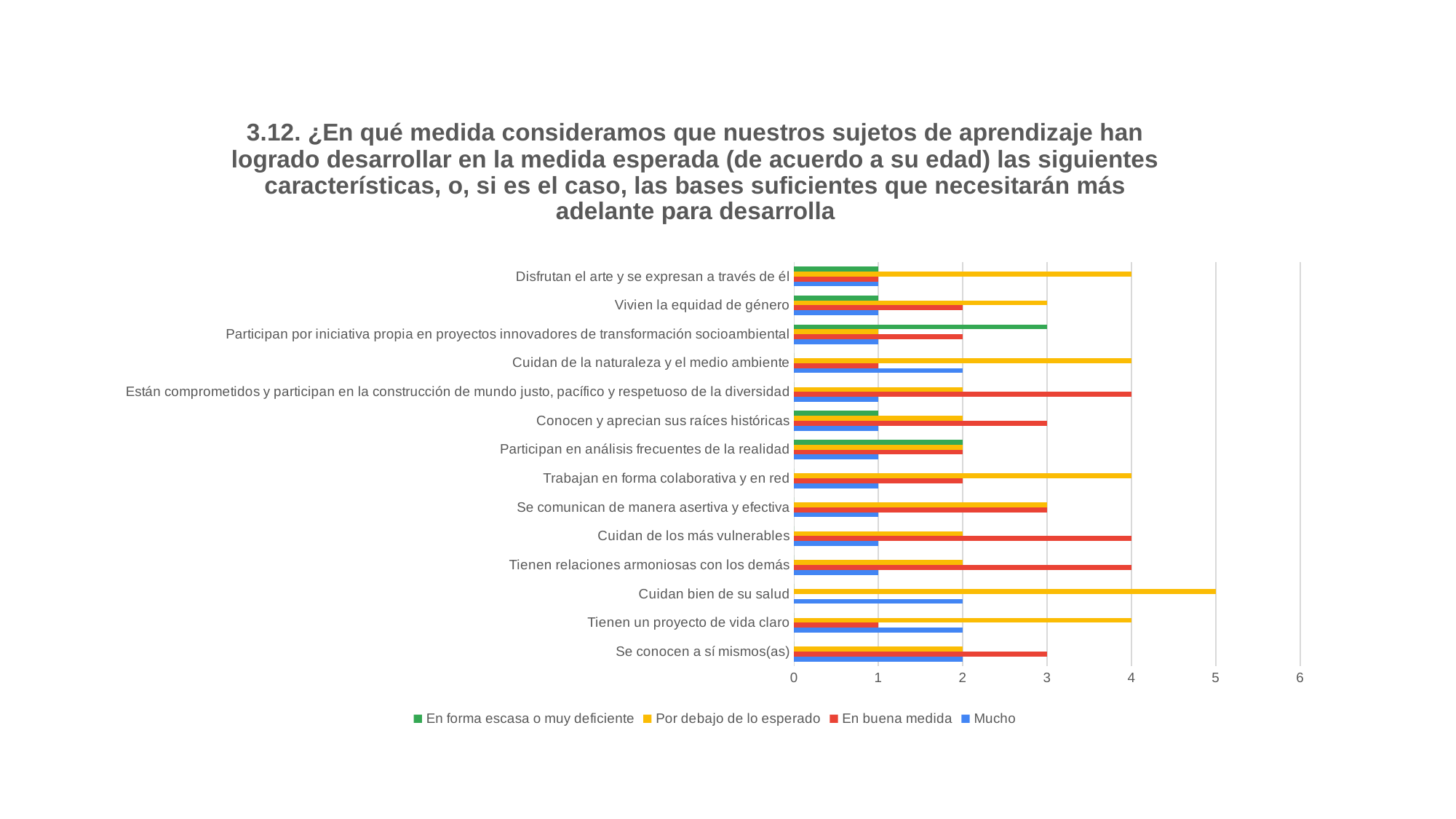
How many series does the legend list? 4 For "Conocen y aprecian sus raíces históricas", which is larger: "En buena medida" or "Por debajo de lo esperado"? En buena medida How many categories are plotted on the chart? 14 What is the value of "Por debajo de lo esperado" for "Cuidan bien de su salud"? 5 Is the value of "Por debajo de lo esperado" for "Cuidan bien de su salud" greater or less than 4? greater What is the value of "En forma escasa o muy deficiente" for "Participan por iniciativa propia en proyectos innovadores de transformación socioambiental"? 3 What is the difference between "Por debajo de lo esperado" and "En buena medida" for "Disfrutan el arte y se expresan a través de él"? 3 What is the value of "En buena medida" for "Cuidan de los más vulnerables"? 4 Which colour represents the "Mucho" series in the legend? blue What kind of chart is shown on the slide? bar chart What is the value of "Mucho" for "Se conocen a sí mismos(as)"? 2 Which category has the highest value for "Por debajo de lo esperado"? Cuidan bien de su salud